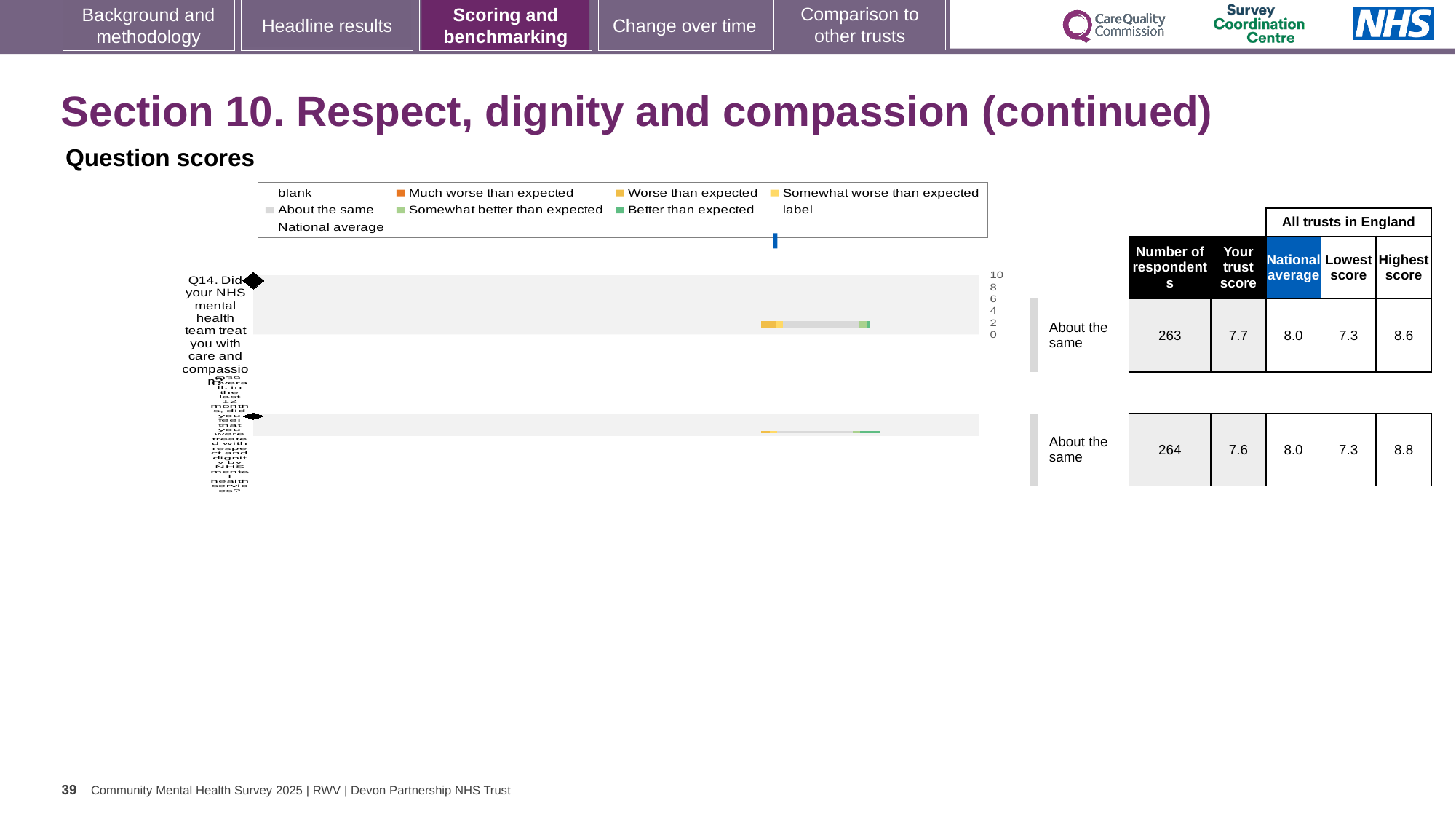
What kind of chart is used to show the question scores on this slide? bar chart What is the highest score among all trusts in England for the second question (Q39)? 8.8 What benchmark category is shown next to the Q14 bar in the chart? About the same How many respondents answered Q14? 263 What is the trust score for the second question (Q39) in the chart? 7.6 Which question had more respondents, Q14 or the second question (Q39)? Q39 What is the difference between the highest and lowest trust scores in England for Q14? 1.3 What is the trust score for Q14 (Did your NHS mental health team treat you with care and compassion?)? 7.7 What is the national average score for Q14? 8.0 Which is larger for Q14: the trust score or the national average? National average How many questions are plotted in the question scores chart? 2 What is the lowest score among all trusts in England for Q14? 7.3